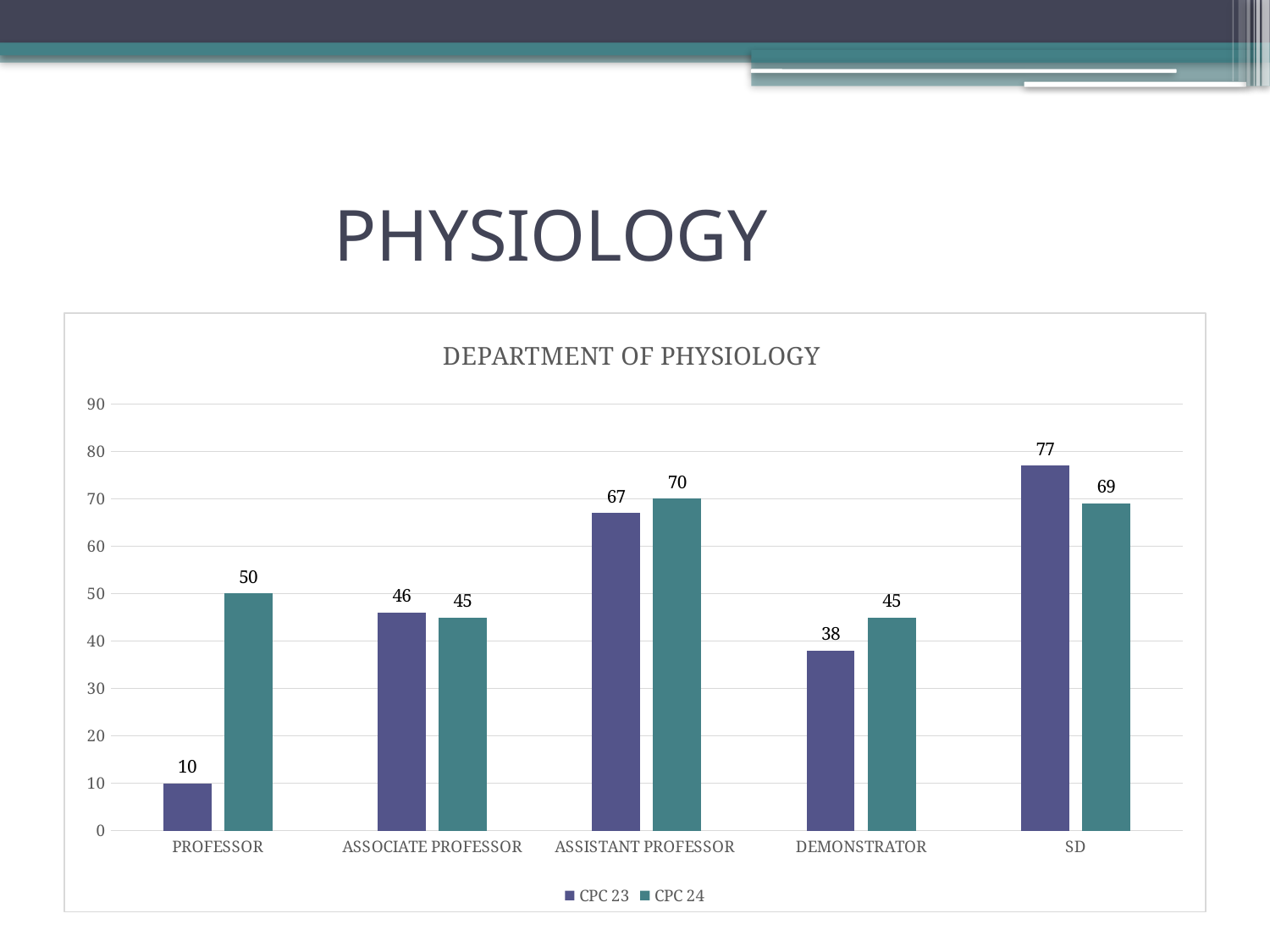
How many series does the legend list? 2 What is the CPC 24 value for DEMONSTRATOR? 45 What is the CPC 23 value for PROFESSOR? 10 For DEMONSTRATOR, which series has the larger value, CPC 23 or CPC 24? CPC 24 What is the CPC 24 value for ASSISTANT PROFESSOR? 70 Which category has the lowest CPC 23 value? PROFESSOR Which category has the lowest CPC 24 value? ASSOCIATE PROFESSOR and DEMONSTRATOR What type of chart is shown on the slide? Bar chart How many categories are shown on the x axis? 5 Which category has the highest CPC 23 value? SD What is the difference between the CPC 24 and CPC 23 values for PROFESSOR? 40 What is the difference between the CPC 23 and CPC 24 values for SD? 8